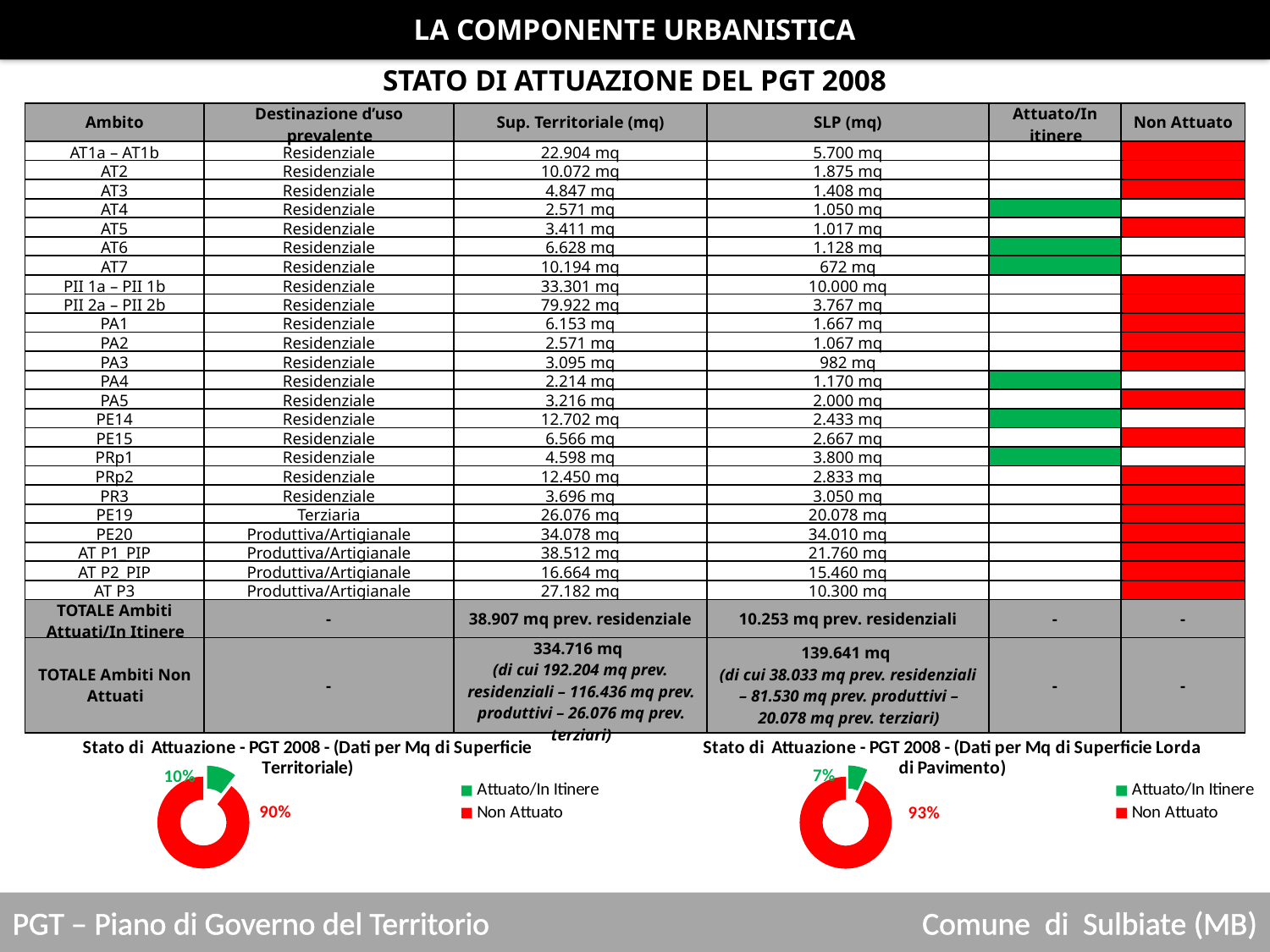
In the right chart (Dati per Mq di Superficie Lorda di Pavimento), what share is labelled Attuato/In Itinere? 7% Which chart shows a larger share for Attuato/In Itinere, the left one (Superficie Territoriale) or the right one (Superficie Lorda di Pavimento)? the left one (Superficie Territoriale) How many entries does the legend of the left chart (Dati per Mq di Superficie Territoriale) list? 2 In the left chart (Dati per Mq di Superficie Territoriale), what share is labelled Non Attuato? 90% In the left chart (Dati per Mq di Superficie Territoriale), what is the difference in percentage points between Non Attuato and Attuato/In Itinere? 80 In the left chart (Dati per Mq di Superficie Territoriale), what share is labelled Attuato/In Itinere? 10% In the right chart (Dati per Mq di Superficie Lorda di Pavimento), what colour represents Non Attuato? red In the right chart (Dati per Mq di Superficie Lorda di Pavimento), which category has the smallest share? Attuato/In Itinere In the right chart (Dati per Mq di Superficie Lorda di Pavimento), what is the difference in percentage points between Non Attuato and Attuato/In Itinere? 86 In the left chart (Dati per Mq di Superficie Territoriale), which category has the largest share? Non Attuato What type of chart is used at the bottom of the slide for the Stato di Attuazione data? doughnut (pie) chart In the right chart (Dati per Mq di Superficie Lorda di Pavimento), what share is labelled Non Attuato? 93%